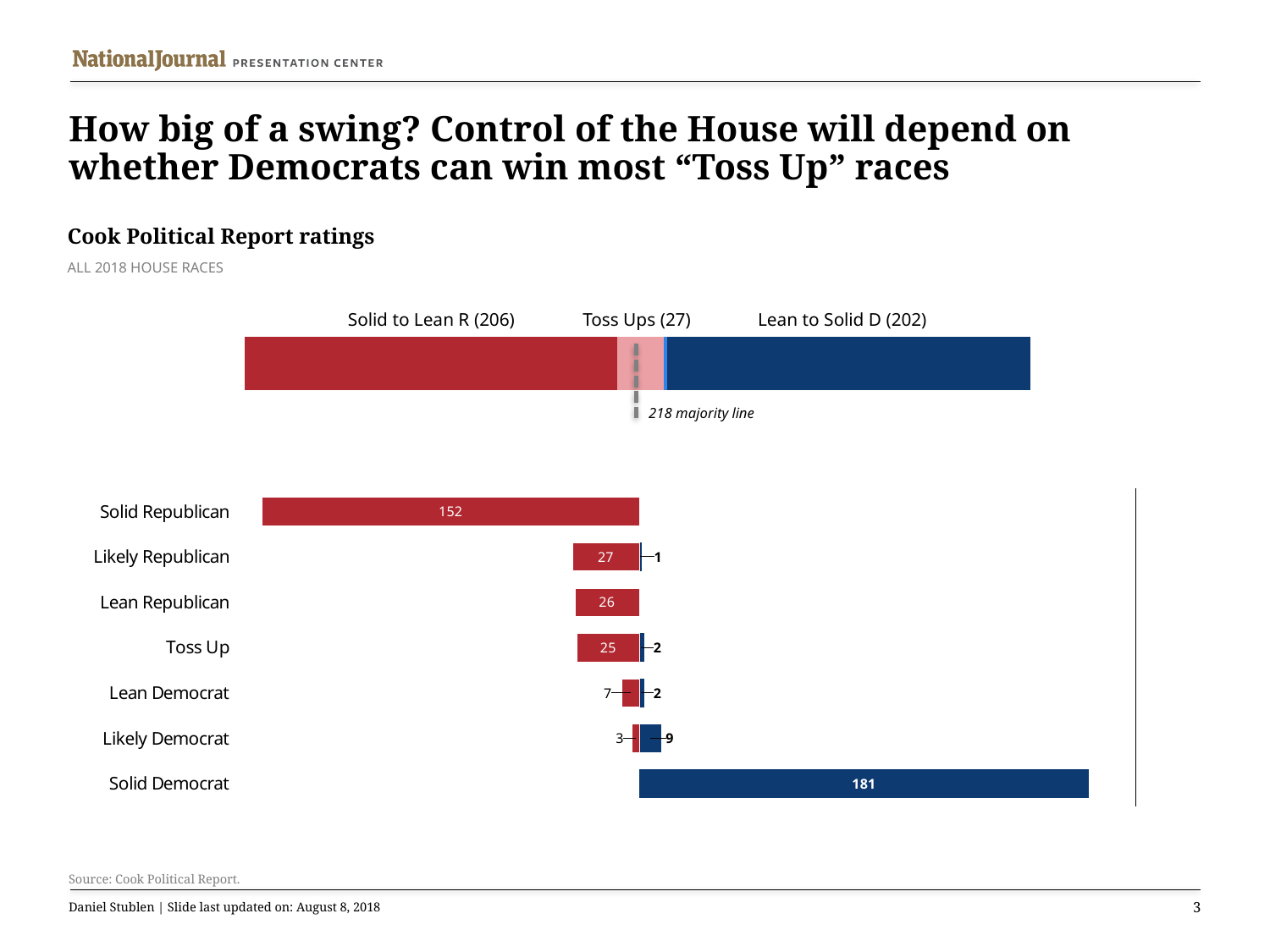
In the bottom bar chart, what is the red value for Solid Republican? 152 In the bottom bar chart, what is the blue value for Likely Democrat? 9 In the bottom bar chart, what is the red value for Lean Democrat? 7 In the bottom bar chart, which is larger: the red value for Solid Republican or the blue value for Solid Democrat? Solid Democrat In the top stacked bar, what is the difference between Solid to Lean R and Lean to Solid D? 4 In the bottom bar chart, what is the red value for Toss Up? 25 In the bottom bar chart, what is the difference between the red values for Likely Republican and Lean Republican? 1 In the bottom bar chart, which category has the smallest red value? Likely Democrat How many categories are shown in the bottom bar chart? 7 In the bottom bar chart, which category has the largest blue value? Solid Democrat In the bottom bar chart, what is the blue value for Solid Democrat? 181 In the top stacked bar, how many races are labeled as Toss Ups? 27